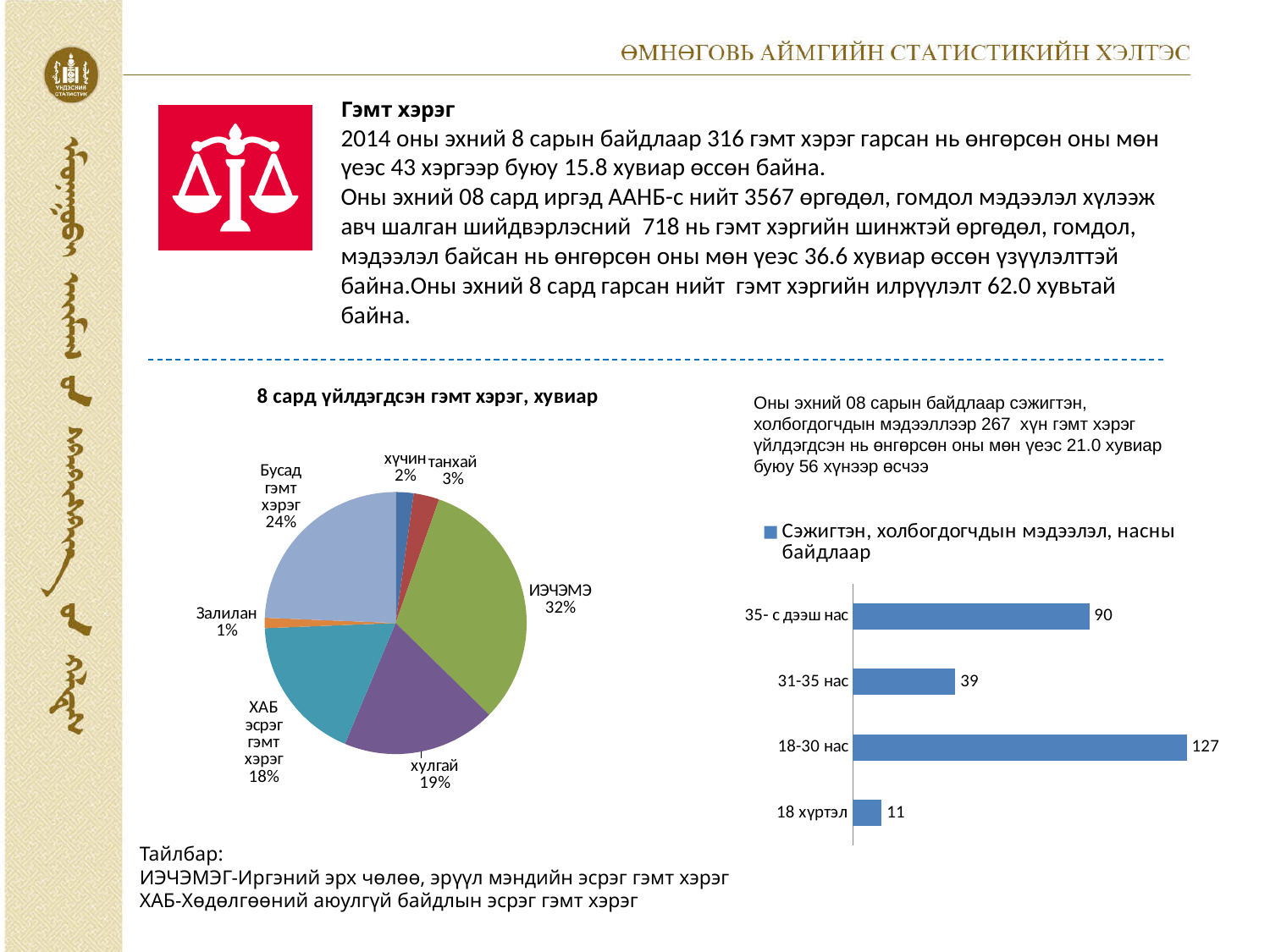
In the bar chart 'Сэжигтэн, холбогдогчдын мэдээлэл, насны байдлаар', what is the value for 31-35 нас? 39 In the pie chart '8 сард үйлдэгдсэн гэмт хэрэг, хувиар', which category has the largest slice? ИЭЧЭМЭ What kind of chart is the chart on the left of the slide? Pie chart In the pie chart '8 сард үйлдэгдсэн гэмт хэрэг, хувиар', what share is labelled for хулгай? 19% In the bar chart 'Сэжигтэн, холбогдогчдын мэдээлэл, насны байдлаар', what is the difference between 18-30 нас and 35- с дээш нас? 37 In the pie chart '8 сард үйлдэгдсэн гэмт хэрэг, хувиар', how many slices are there? 7 In the pie chart '8 сард үйлдэгдсэн гэмт хэрэг, хувиар', which category has the smallest slice? Залилан In the bar chart 'Сэжигтэн, холбогдогчдын мэдээлэл, насны байдлаар', what is the value for 18-30 нас? 127 In the pie chart '8 сард үйлдэгдсэн гэмт хэрэг, хувиар', what is the difference in percentage points between Бусад гэмт хэрэг and ХАБ эсрэг гэмт хэрэг? 6 In the bar chart 'Сэжигтэн, холбогдогчдын мэдээлэл, насны байдлаар', how many age categories are shown? 4 In the pie chart '8 сард үйлдэгдсэн гэмт хэрэг, хувиар', what share is labelled for ИЭЧЭМЭ? 32% In the bar chart 'Сэжигтэн, холбогдогчдын мэдээлэл, насны байдлаар', which age group has the lowest value? 18 хүртэл